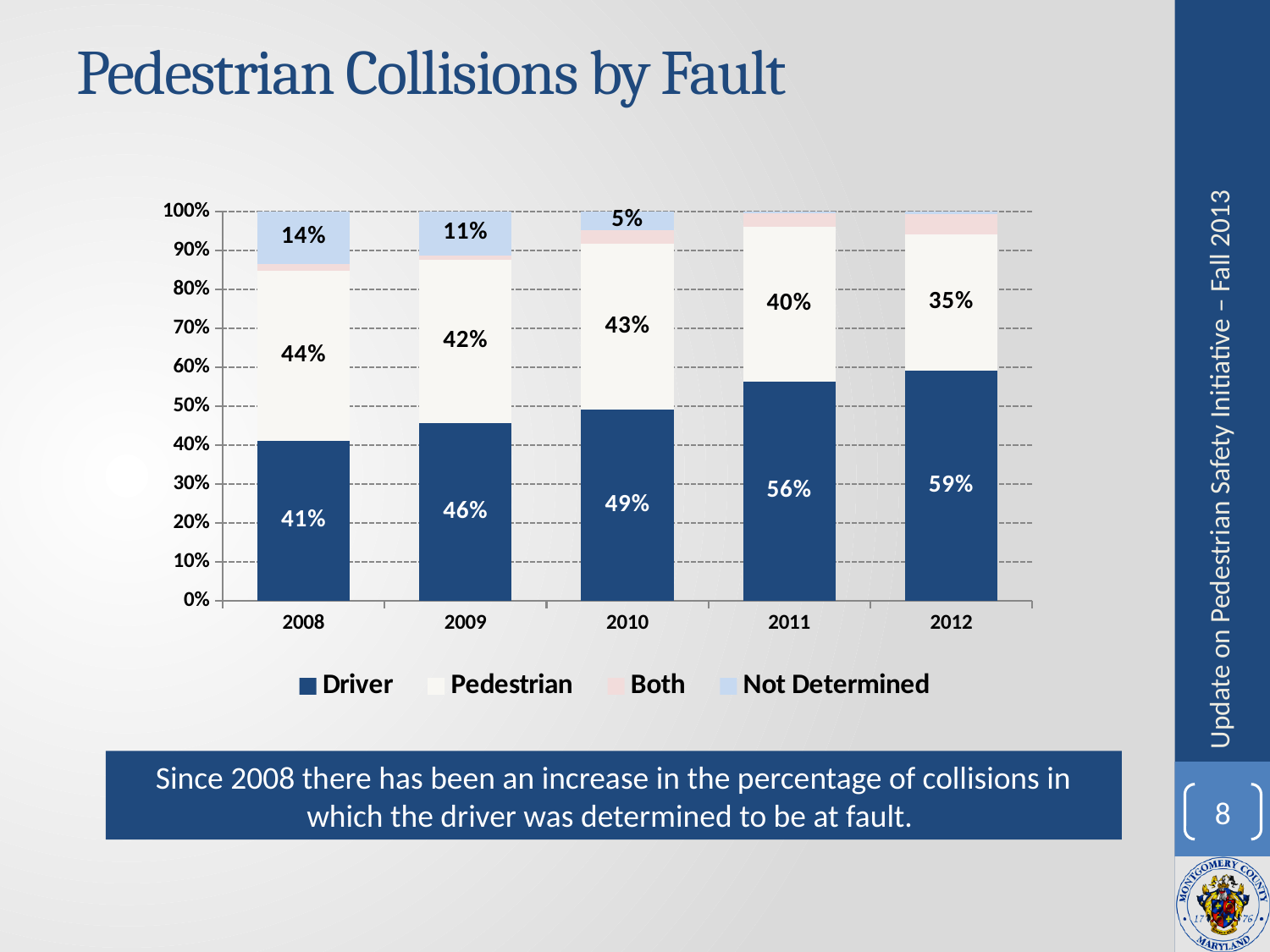
How many series does the legend list? 4 What is the Not Determined share for 2009? 11% What is the Pedestrian share for 2010? 43% What percentage of pedestrian collisions in 2008 were the driver's fault? 41% Which is larger in 2011, the Driver share or the Pedestrian share? Driver In which year is the Driver share the highest? 2012 What kind of chart is shown on the slide? Stacked bar chart Is the Driver share for 2011 greater or less than 50%? greater Does the Driver share rise or fall from 2008 to 2012? Rise How many years are shown on the x axis? 5 In which year is the Pedestrian share the lowest? 2012 By how many percentage points did the Driver share increase from 2008 to 2012? 18 percentage points